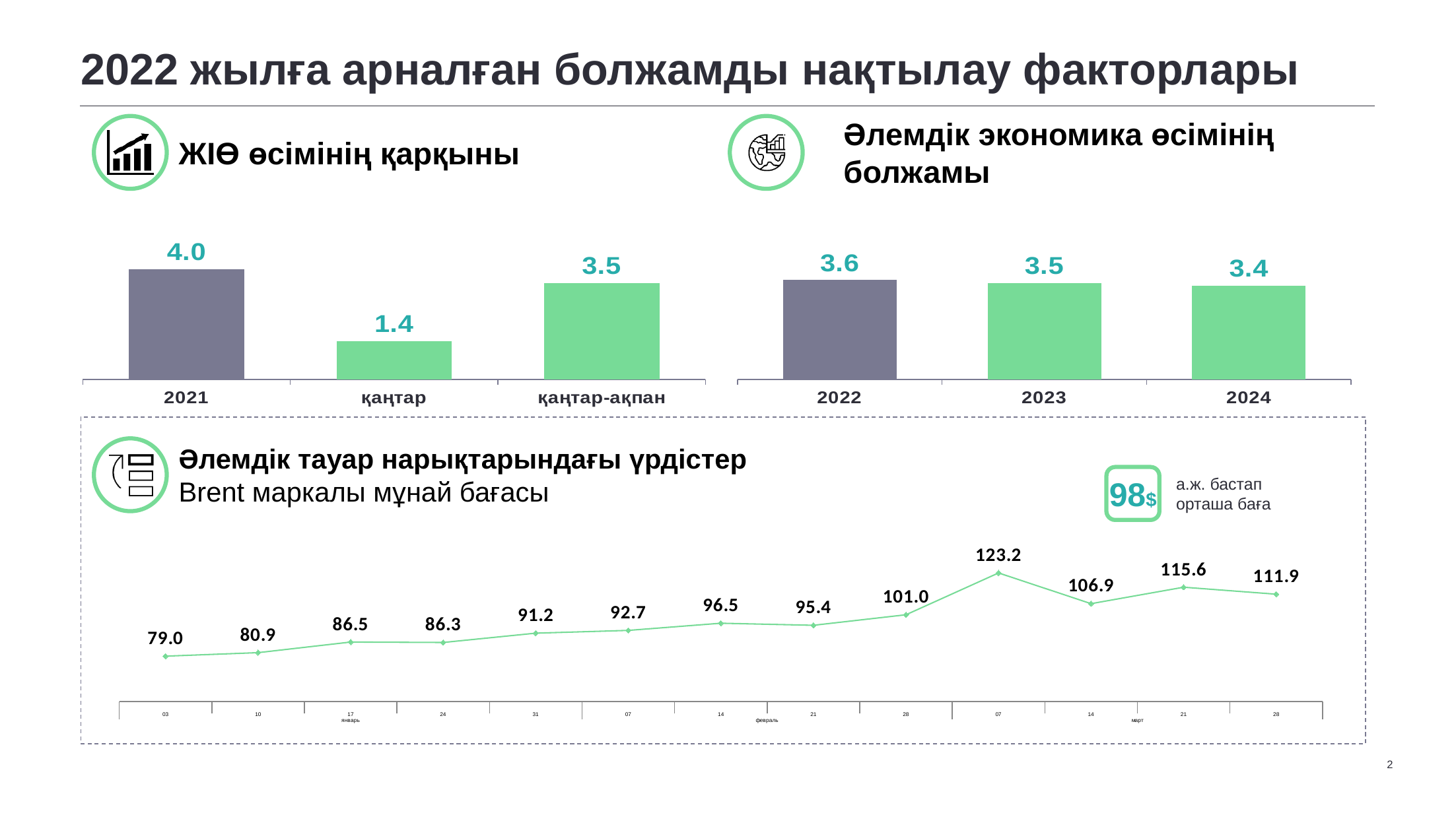
In the top-left chart titled "ЖІӨ өсімінің қарқыны", what is the difference between the values for 2021 and қаңтар-ақпан? 0.5 In the bottom chart titled "Brent маркалы мұнай бағасы", what is the lowest value shown? 79.0 In the top-left chart titled "ЖІӨ өсімінің қарқыны", what is the value for 2021? 4.0 In the bottom chart titled "Brent маркалы мұнай бағасы", what is the difference between the highest value (123.2) and the last value (111.9)? 11.3 In the top-right chart titled "Әлемдік экономика өсімінің болжамы", what is the value for 2023? 3.5 What kind of chart is the top-right chart titled "Әлемдік экономика өсімінің болжамы"? bar chart In the bottom chart titled "Brent маркалы мұнай бағасы", what is the highest value shown? 123.2 In the top-left chart titled "ЖІӨ өсімінің қарқыны", which category has the lowest value? қаңтар In the top-right chart titled "Әлемдік экономика өсімінің болжамы", do the values rise or fall from 2022 to 2024? fall In the top-right chart titled "Әлемдік экономика өсімінің болжамы", which year has the highest value? 2022 What kind of chart is the bottom chart titled "Brent маркалы мұнай бағасы"? line chart In the top-left chart titled "ЖІӨ өсімінің қарқыны", how many bars are shown? 3